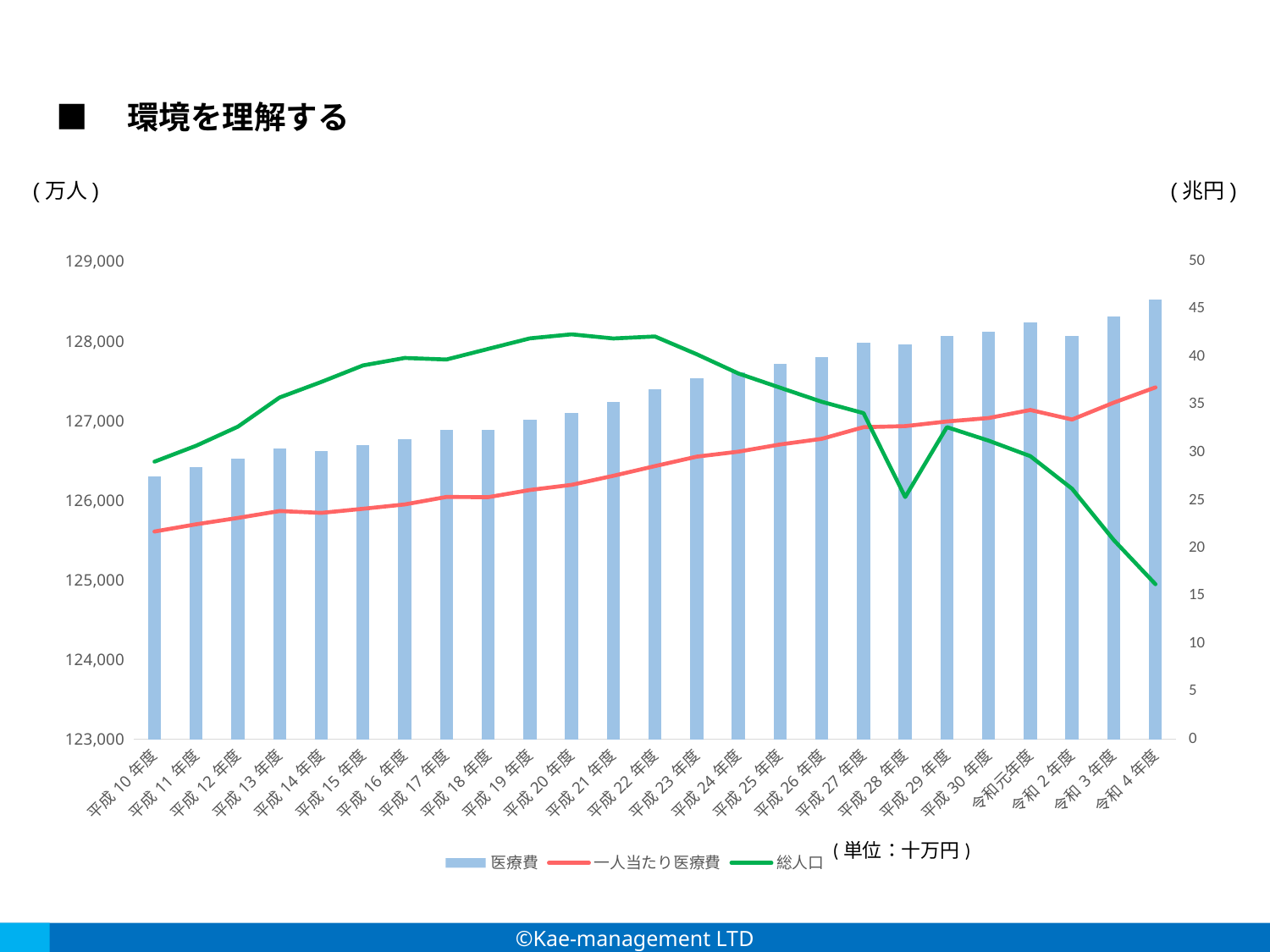
What kind of chart is this? Combined bar and line chart Which fiscal year has the lowest 医療費 bar? 平成10年度 What colour is the 総人口 line in the legend? Green Is the 総人口 value for 令和4年度 greater or less than 126,000 on the left axis? less Do the 医療費 bars generally rise or fall from 平成10年度 to 令和4年度? Rise Is the 医療費 value for 平成10年度 greater or less than 30 on the right axis? less How many fiscal years are shown on the x axis? 25 Which fiscal year has the lowest value on the 総人口 line? 令和4年度 How many series does the legend list? 3 Which fiscal year has the highest 医療費 bar? 令和4年度 Is the 医療費 value for 令和4年度 greater or less than 40 on the right axis? greater Which is larger, the 総人口 value for 平成10年度 or for 令和4年度? 平成10年度